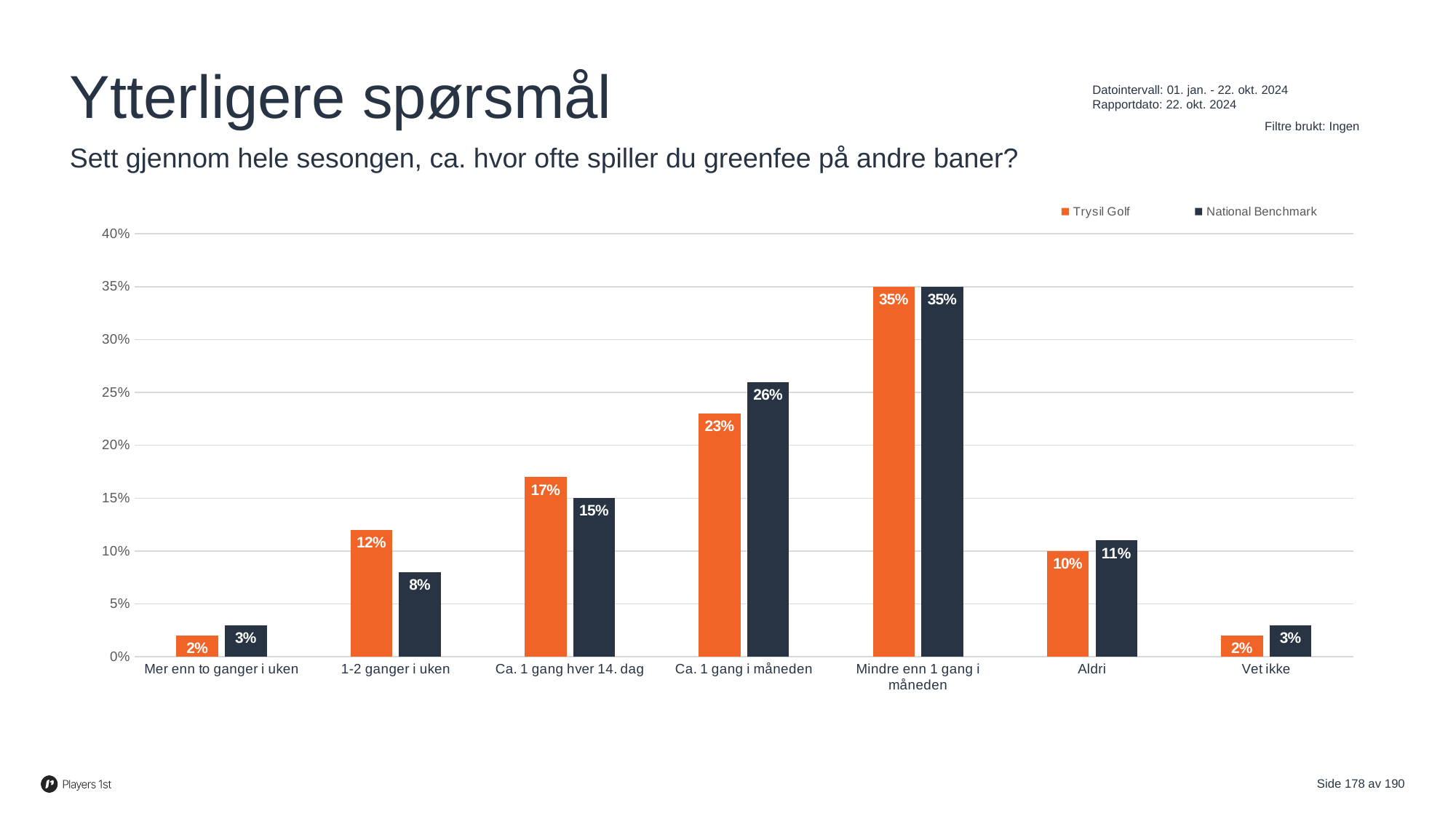
Which category has the highest Trysil Golf value? Mindre enn 1 gang i måneden Is the National Benchmark value for "Ca. 1 gang i måneden" greater or less than 25%? greater What is the difference between the Trysil Golf and National Benchmark values for "1-2 ganger i uken"? 4% Which category has the lowest National Benchmark value? Mer enn to ganger i uken and Vet ikke (both 3%) What is the National Benchmark value for "1-2 ganger i uken"? 8% Which series is shown in orange? Trysil Golf For "Ca. 1 gang hver 14. dag", which series has the larger value, Trysil Golf or National Benchmark? Trysil Golf What is the Trysil Golf value for "Ca. 1 gang i måneden"? 23% How many categories are shown on the x axis? 7 What kind of chart is shown on the slide? Bar chart How many series does the legend list? 2 What is the Trysil Golf value for "Aldri"? 10%